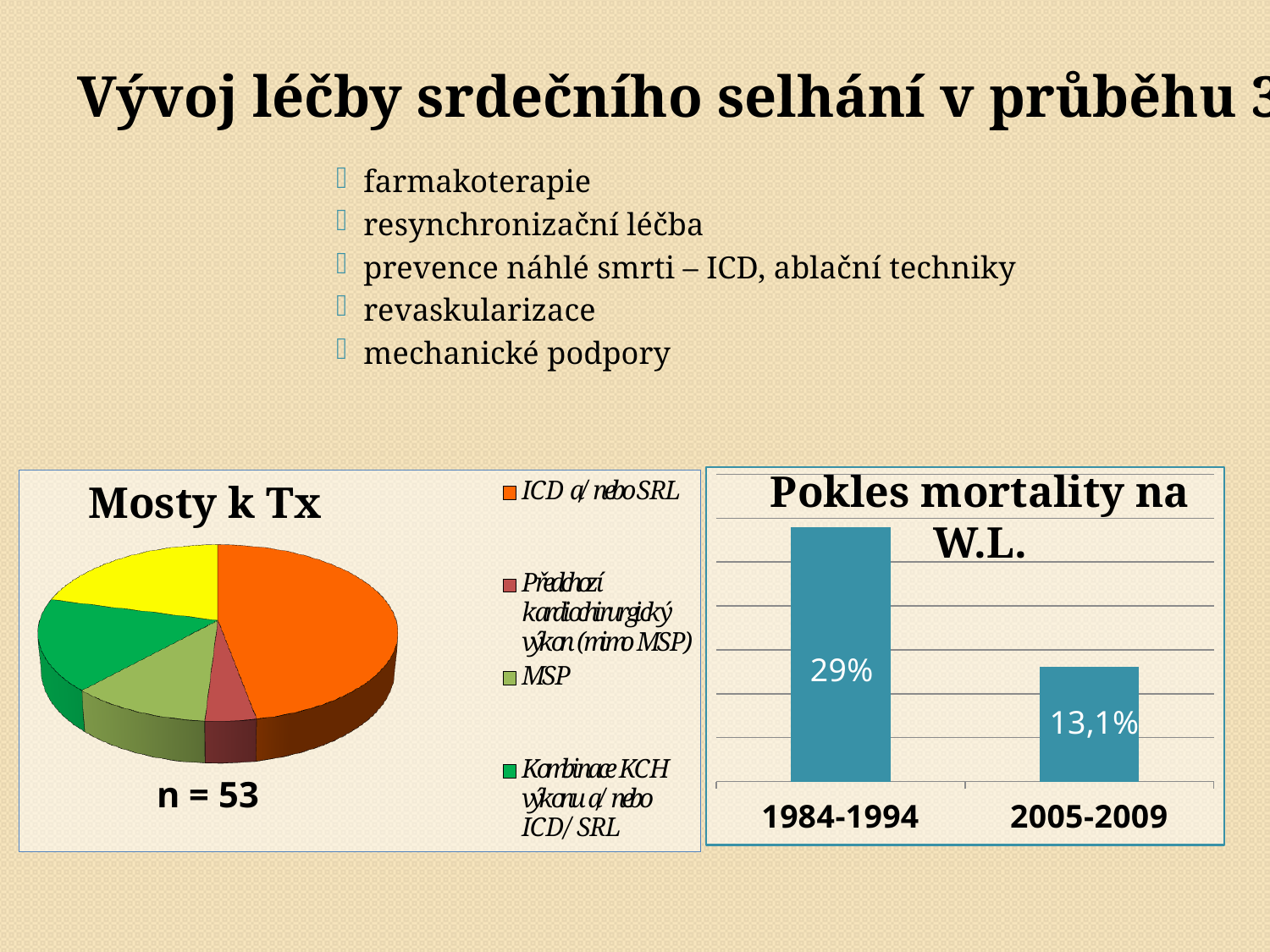
In the pie chart "Mosty k Tx", what colour is the slice for "ICD a/nebo SRL"? Orange In the chart titled "Pokles mortality na W.L.", what is the difference between the 1984-1994 value and the 2005-2009 value? 15,9% In the chart titled "Pokles mortality na W.L.", what is the value for 2005-2009? 13,1% In the pie chart "Mosty k Tx", which legend category has the largest slice? ICD a/nebo SRL In the chart titled "Pokles mortality na W.L.", do the values rise or fall from 1984-1994 to 2005-2009? Fall In the chart titled "Pokles mortality na W.L.", how many periods (bars) are shown? 2 What kind of chart is "Pokles mortality na W.L."? Bar chart In the pie chart "Mosty k Tx", what sample size (n) is stated below the chart? n = 53 In the chart titled "Pokles mortality na W.L.", which period has the lowest value? 2005-2009 In the chart titled "Pokles mortality na W.L.", what is the value for 1984-1994? 29% In the chart titled "Pokles mortality na W.L.", which period has the higher value? 1984-1994 What kind of chart is "Mosty k Tx"? Pie chart